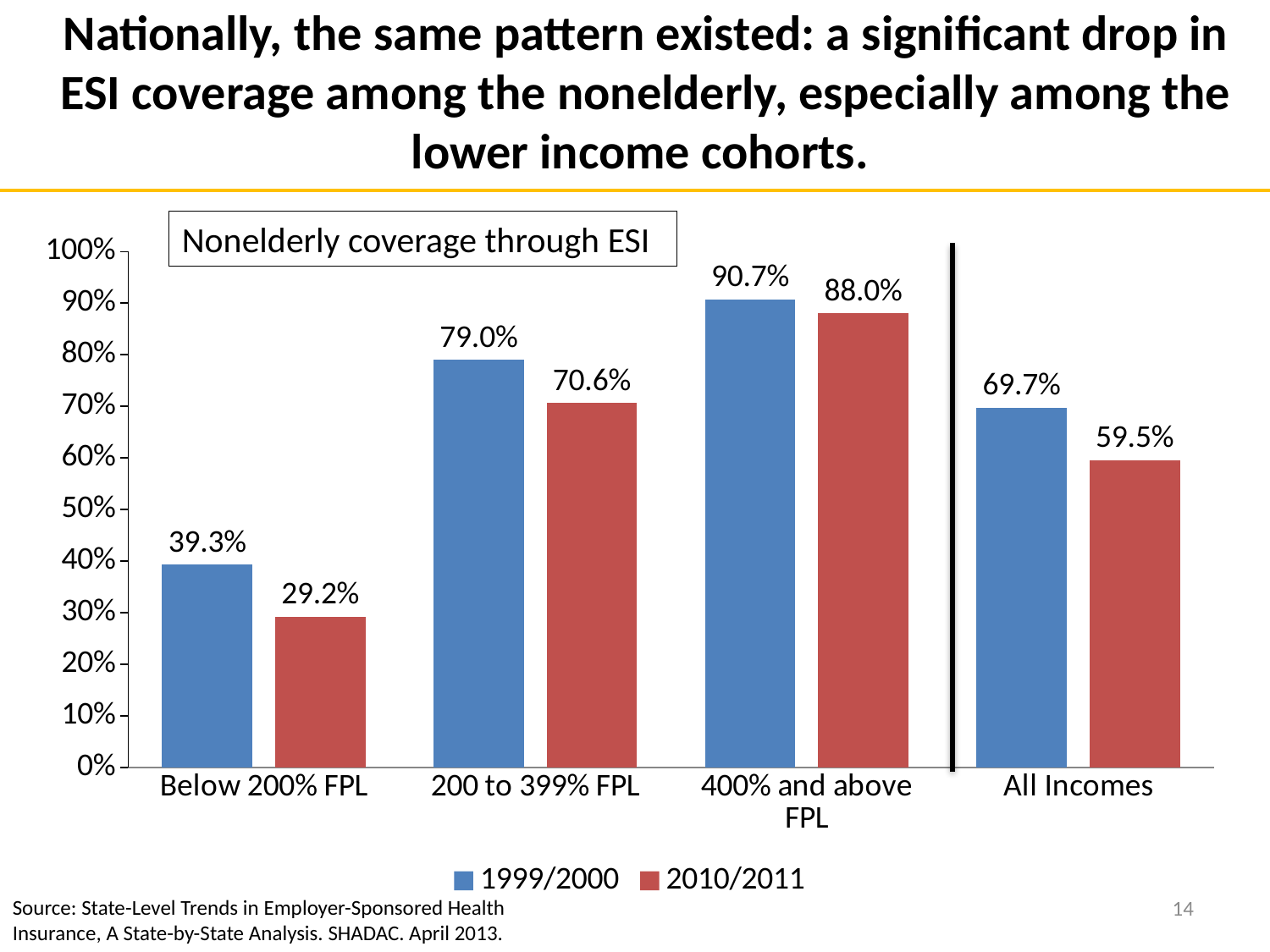
What type of chart is shown on the slide? Bar chart Which is larger: the 2010/2011 rate for 200 to 399% FPL or the 1999/2000 rate for All Incomes? 2010/2011 rate for 200 to 399% FPL What was the nonelderly ESI coverage rate for 200 to 399% FPL in 2010/2011? 70.6% What is the difference between the 1999/2000 and 2010/2011 coverage rates for 400% and above FPL? 2.7 percentage points How many income categories are shown on the x axis? 4 What was the nonelderly ESI coverage rate for All Incomes in 2010/2011? 59.5% How many series does the legend list? 2 What is the title shown in the box above the chart? Nonelderly coverage through ESI By how many percentage points did ESI coverage for Below 200% FPL fall from 1999/2000 to 2010/2011? 10.1 percentage points Which income category had the lowest ESI coverage rate in 2010/2011? Below 200% FPL Which income category had the highest ESI coverage rate in 1999/2000? 400% and above FPL What was the nonelderly ESI coverage rate for Below 200% FPL in 1999/2000? 39.3%